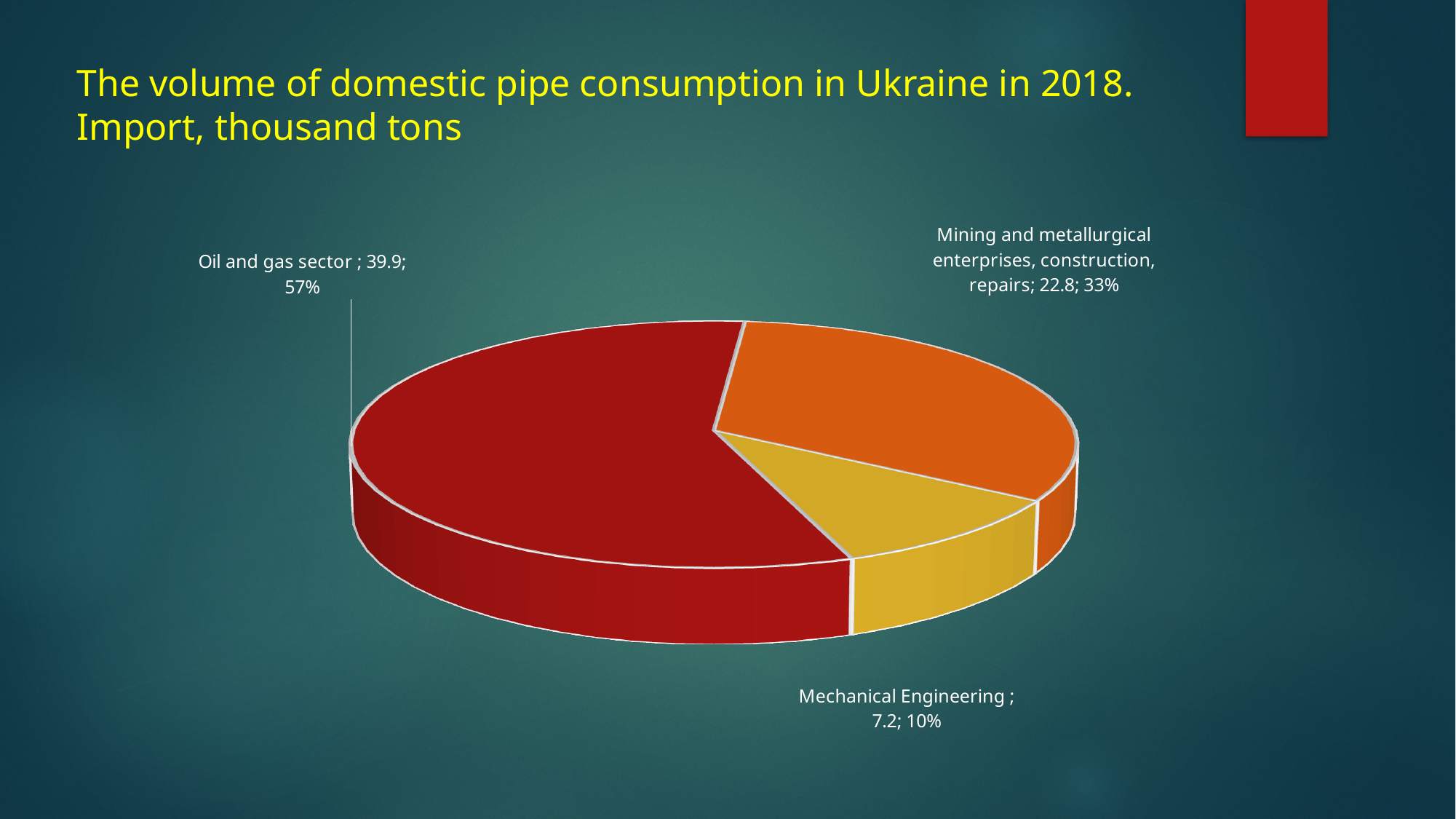
Which category has the largest slice? Oil and gas sector What is the value for Mining and metallurgical enterprises, construction, repairs? 22.8 What type of chart is shown on the slide? Pie chart Which category has the smallest slice? Mechanical Engineering What share of the pie does Mechanical Engineering represent? 10% What share of the pie does the Oil and gas sector represent? 57% What is the value for Mechanical Engineering? 7.2 What is the value for the Oil and gas sector? 39.9 How many categories are shown in the pie chart? 3 What is the difference between the Oil and gas sector value and the Mechanical Engineering value? 32.7 What share of the pie does Mining and metallurgical enterprises, construction, repairs represent? 33% Which is larger: Mining and metallurgical enterprises, construction, repairs or Mechanical Engineering? Mining and metallurgical enterprises, construction, repairs